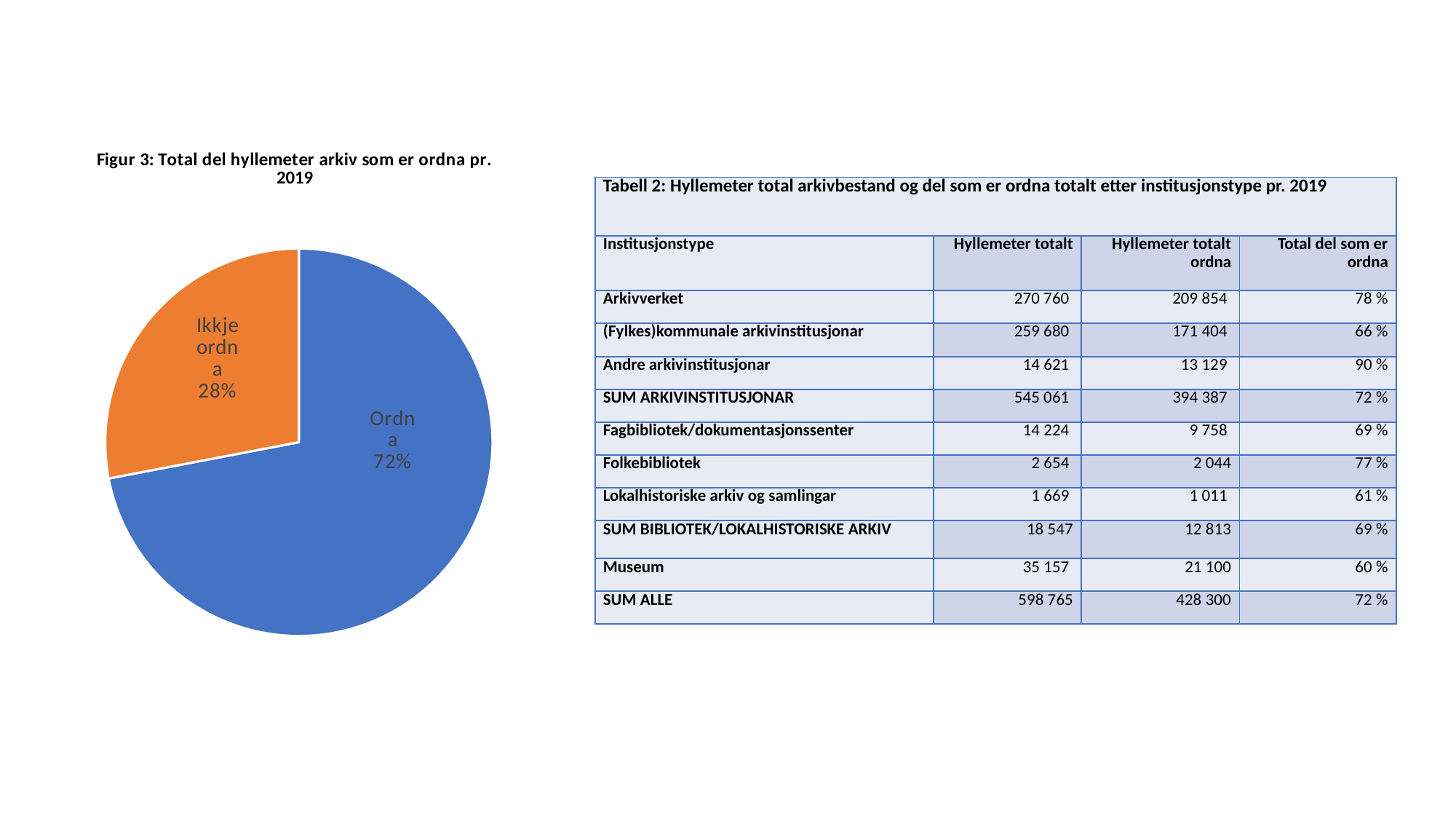
Which slice of the pie chart is the largest? Ordna What is the title of the pie chart? Figur 3: Total del hyllemeter arkiv som er ordna pr. 2019 In the pie chart, what share is labelled 'Ikkje ordna'? 28% What kind of chart is Figur 3? pie chart In the pie chart, what share is labelled 'Ordna'? 72% Which slice of the pie chart is the smallest? Ikkje ordna In the pie chart, is the 'Ordna' slice larger or smaller than the 'Ikkje ordna' slice? larger In the pie chart, what is the difference in percentage points between the 'Ordna' and 'Ikkje ordna' slices? 44 How many slices does the pie chart have? 2 What colour is the 'Ikkje ordna' slice in the pie chart? orange